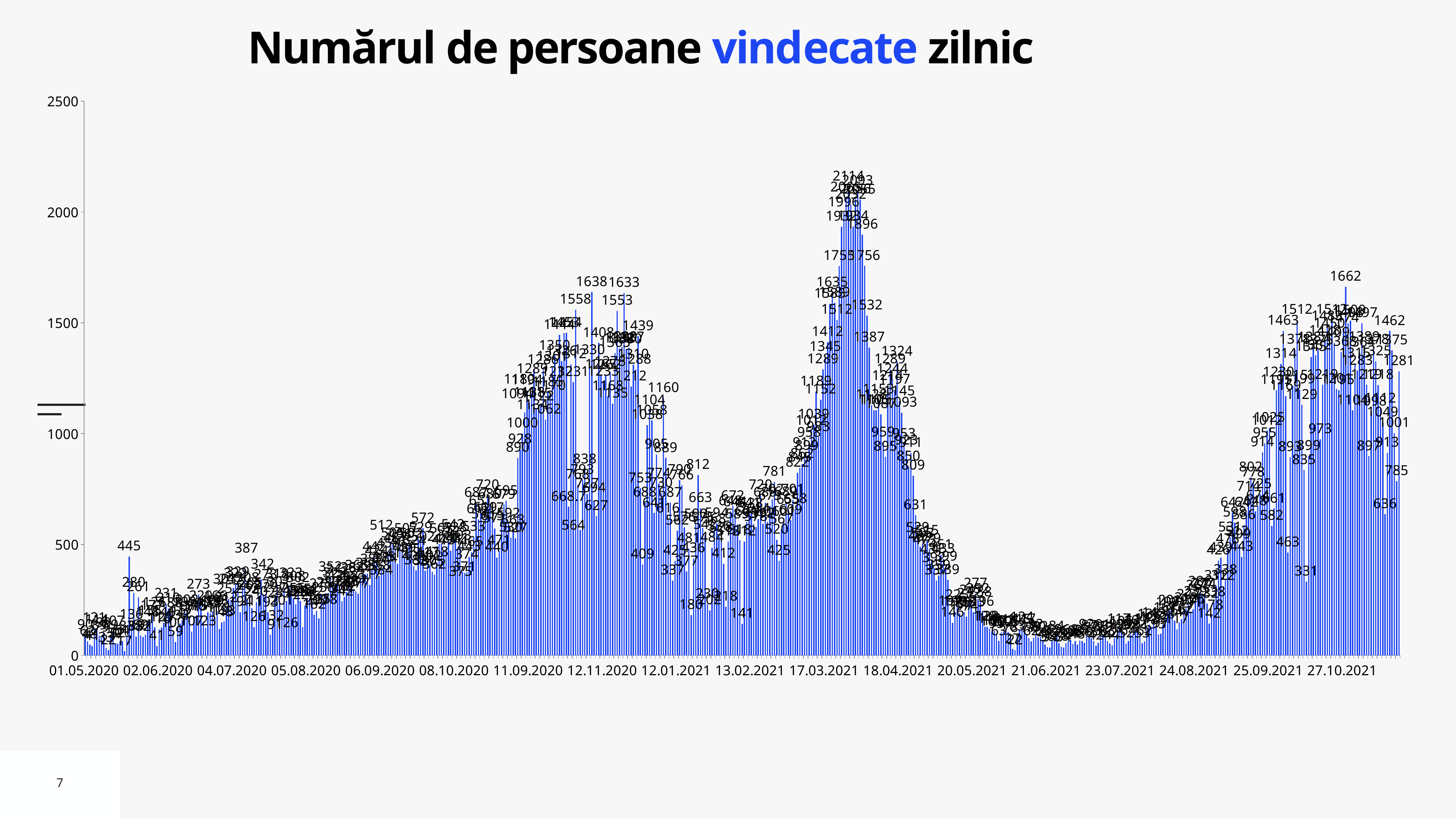
What is the highest labeled value in the wave around 27.10.2021? 1662 Which peak is higher: the one around 17.03.2021 or the one around 12.11.2020? the one around 17.03.2021 What kind of chart is shown on the slide? bar chart What is the highest value labeled on the chart? 2114 What is the highest labeled value between 04.07.2020 and 05.08.2020? 387 Is the tallest bar on the chart greater or less than 2000? greater Is the value of the first bar at 01.05.2020 greater or less than 500? less What is the title of the chart? Numărul de persoane vindecate zilnic Do the values rise or fall between 23.07.2021 and 25.09.2021? rise Do the values rise or fall between 18.04.2021 and 21.06.2021? fall What is the highest tick value shown on the vertical axis? 2500